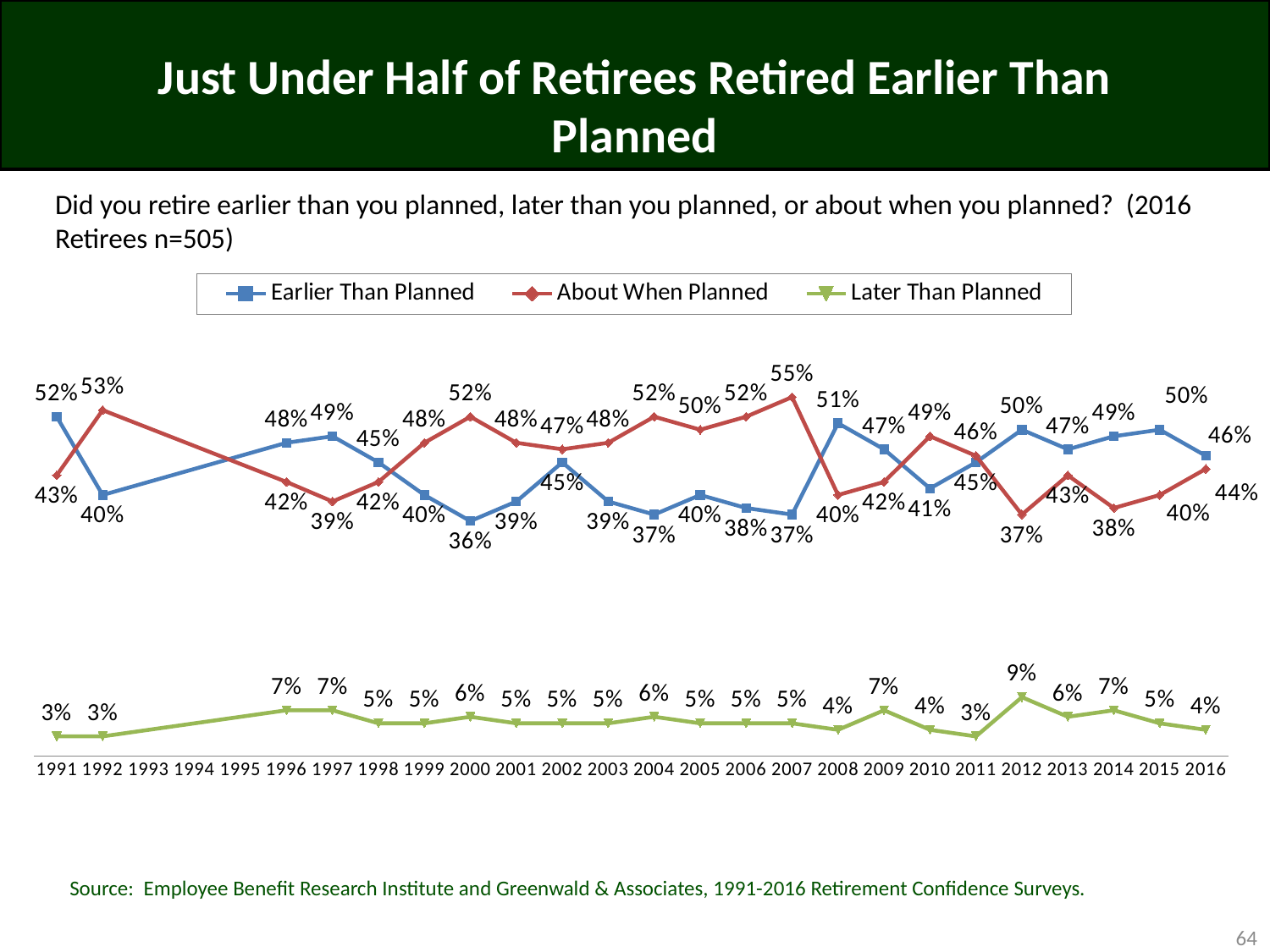
In which year does the About When Planned series reach its highest value? 2007 What is the value for About When Planned in 2007? 55% How many series does the legend list? 3 In which year does the Earlier Than Planned series reach its lowest value? 2000 Which is larger in 2008: Earlier Than Planned or About When Planned? Earlier Than Planned What is the difference between the Earlier Than Planned values in 1991 and 1992? 12 percentage points What is the title of the slide? Just Under Half of Retirees Retired Earlier Than Planned What is the difference between Earlier Than Planned and About When Planned in 2016? 2 percentage points Does the Earlier Than Planned series rise or fall from 2015 to 2016? Fall What type of chart is shown on the slide? Line chart What is the value for Later Than Planned in 2012? 9% What is the value for Earlier Than Planned in 2016? 46%